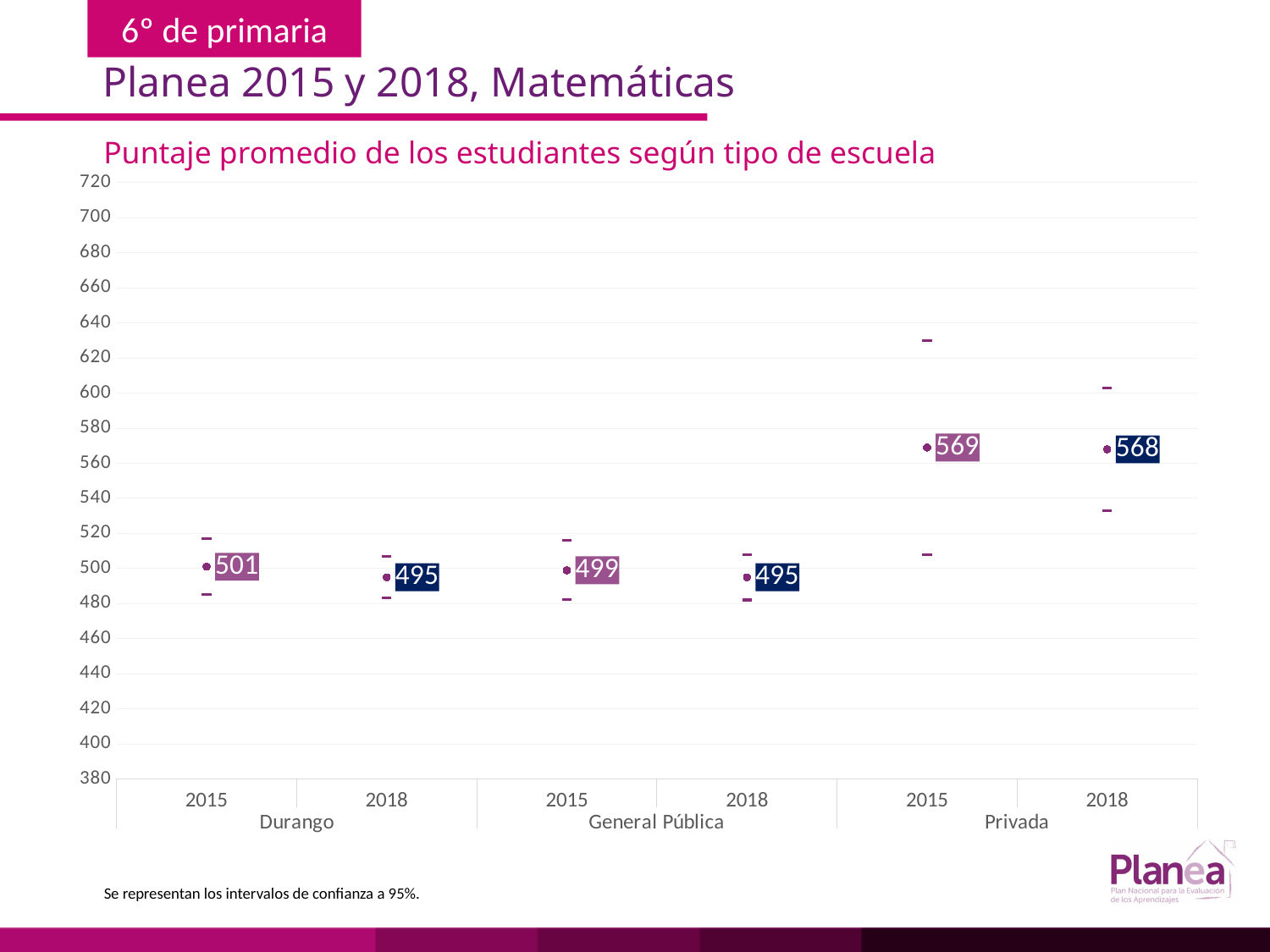
What is the average score for Privada schools in 2018? 568 What is the average score for General Pública schools in 2015? 499 By how much did the Durango average score change from 2015 to 2018? 6 What is the average score for General Pública schools in 2018? 495 Is the value for Privada 2018 greater or less than 540? greater What is the average score for Durango in 2015? 501 Did the Durango average score rise or fall from 2015 to 2018? fall How many data points are plotted on the chart? 6 Which is larger, the Privada 2015 score or the General Pública 2015 score? Privada 2015 Which school type and year has the highest average score? Privada 2015 What is the difference between the Privada 2015 score and the Durango 2015 score? 68 Among the 2015 points, which school type has the lowest average score? General Pública